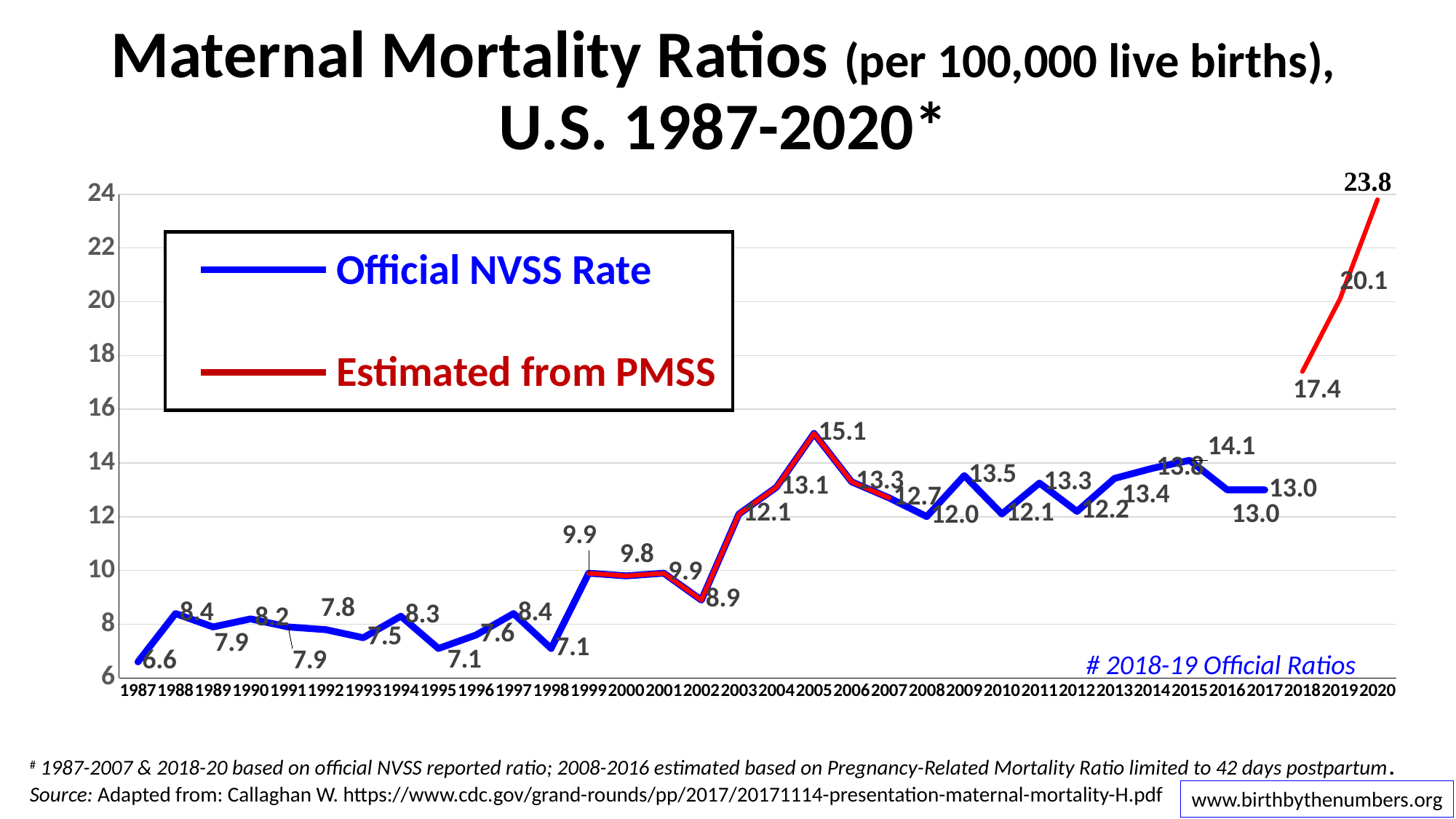
Which year has a higher maternal mortality ratio, 2005 or 2003? 2005 How many series does the legend list? 2 What is the maternal mortality ratio shown for 2005? 15.1 Do the values rise or fall from 2018 to 2020? rise What is the maternal mortality ratio shown for 2018? 17.4 What colour is the line for the Official NVSS Rate in the legend? blue What type of chart is shown on the slide? line chart What is the maternal mortality ratio shown for 2020? 23.8 Which year has the lowest maternal mortality ratio on the chart? 1987 Which year has the highest maternal mortality ratio on the chart? 2020 What is the maternal mortality ratio shown for 1987? 6.6 What is the difference between the ratio for 2020 and the ratio for 2018? 6.4